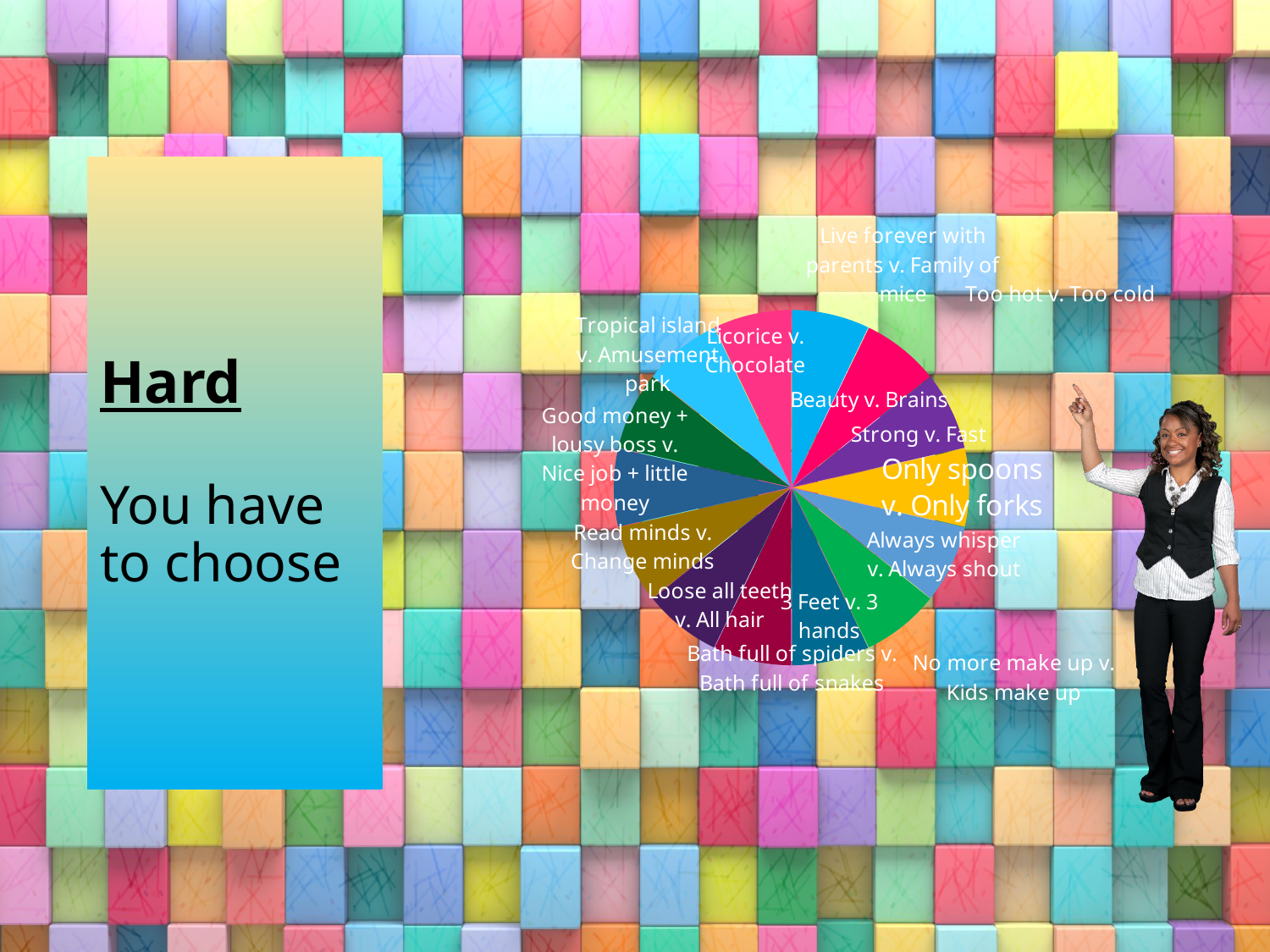
What is the heading text in the box on the left of the slide? Hard What kind of chart is shown on the slide? pie chart Which slice label on the pie chart pairs 'Licorice' with another option? Licorice v. Chocolate Do the slices of the pie chart appear to be equal in size or clearly different in size? equal How many slices does the pie chart have? 14